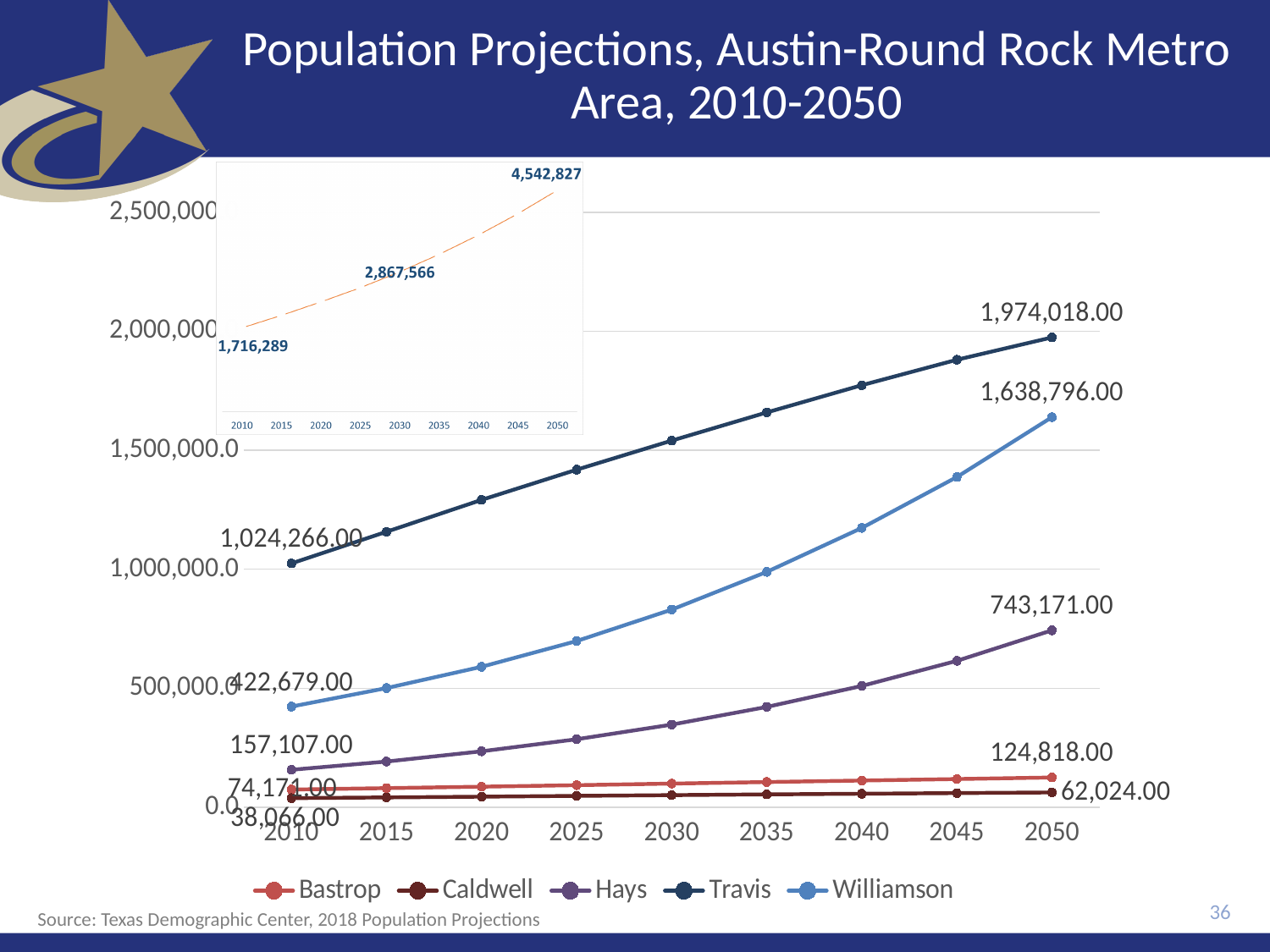
On the main chart, what is the value for Travis in 2050? 1,974,018.00 On the main chart, what is the value for Williamson in 2010? 422,679.00 On the main chart, which is larger in 2050: Bastrop or Caldwell? Bastrop On the small inset chart in the upper left, what is the value shown for 2050? 4,542,827 How many series does the legend of the main chart list? 5 On the main chart, which county has the lowest value in 2010? Caldwell On the main chart, which county has the highest value in 2050? Travis On the main chart, what is the value for Caldwell in 2010? 38,066.00 On the main chart, what is the difference between the Travis values in 2050 and 2010? 949,752.00 What kind of chart is the main chart? Line chart On the main chart, what is the value for Hays in 2050? 743,171.00